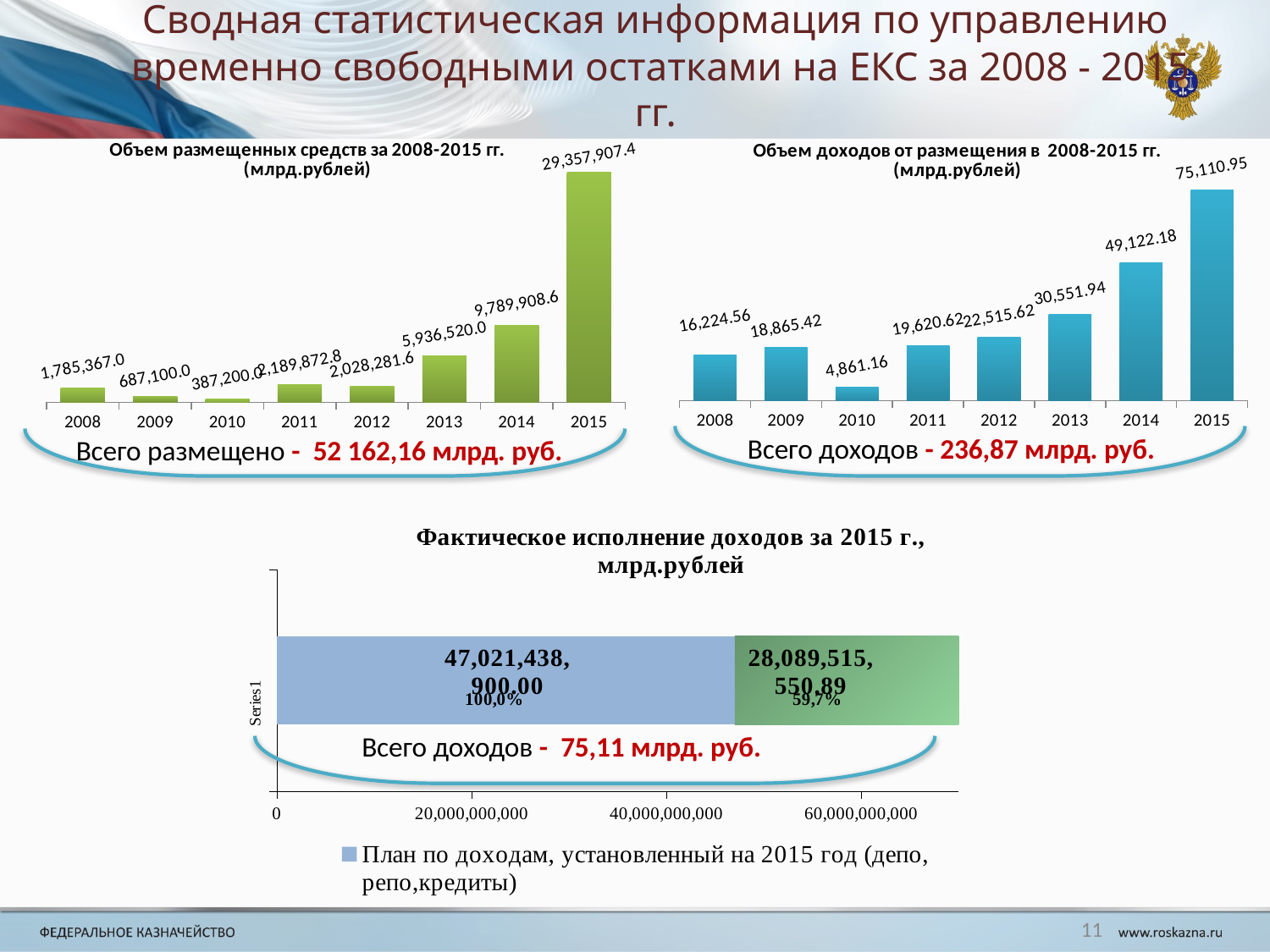
On the bottom chart 'Фактическое исполнение доходов за 2015 г.', is the value of the first (blue) segment greater or less than 40,000,000,000? greater On the chart 'Объем доходов от размещения в 2008-2015 гг.', which year has the highest value? 2015 On the chart 'Объем размещенных средств за 2008-2015 гг.', which year has the lowest value? 2010 On the chart 'Объем размещенных средств за 2008-2015 гг.', what is the difference between the 2015 and 2014 values? 19,567,998.8 On the chart 'Объем доходов от размещения в 2008-2015 гг.', how many years are shown on the x axis? 8 On the chart 'Объем доходов от размещения в 2008-2015 гг.', what is the difference between the 2015 and 2014 values? 25,988.77 On the chart 'Объем доходов от размещения в 2008-2015 гг.', do the values rise or fall from 2011 to 2015? rise On the chart 'Объем размещенных средств за 2008-2015 гг.', which is larger, the value for 2013 or for 2012? 2013 What kind of chart is 'Фактическое исполнение доходов за 2015 г.'? bar chart On the chart 'Объем размещенных средств за 2008-2015 гг.', what is the value for 2015? 29,357,907.4 On the chart 'Объем размещенных средств за 2008-2015 гг.', what is the value for 2013? 5,936,520.0 On the chart 'Объем доходов от размещения в 2008-2015 гг.', what is the value for 2014? 49,122.18